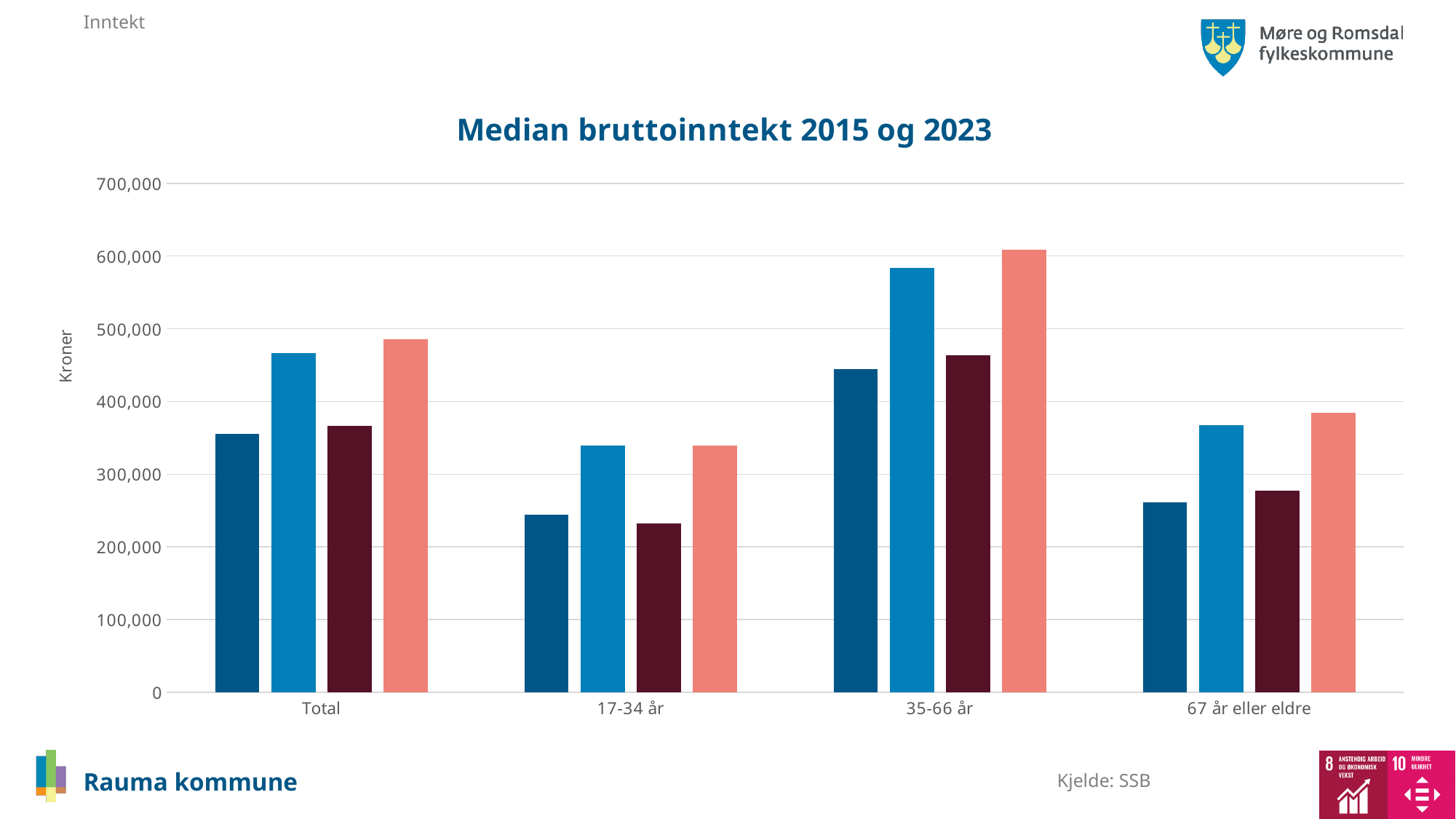
What kind of chart is shown on the slide? bar chart Which is larger: the dark red bar for Total or the dark red bar for 67 år eller eldre? Total Is the value of the light blue bar for 35-66 år greater or less than 500,000? greater Which category has the tallest salmon bar? 35-66 år Is the value of the salmon bar for 67 år eller eldre greater or less than 400,000? less Is the value of the dark blue bar for 67 år eller eldre greater or less than 300,000? less Which category has the lowest dark blue bar? 17-34 år What is the title of the chart? Median bruttoinntekt 2015 og 2023 What label is shown on the vertical axis of the chart? Kroner How many categories are shown along the x axis of the chart? 4